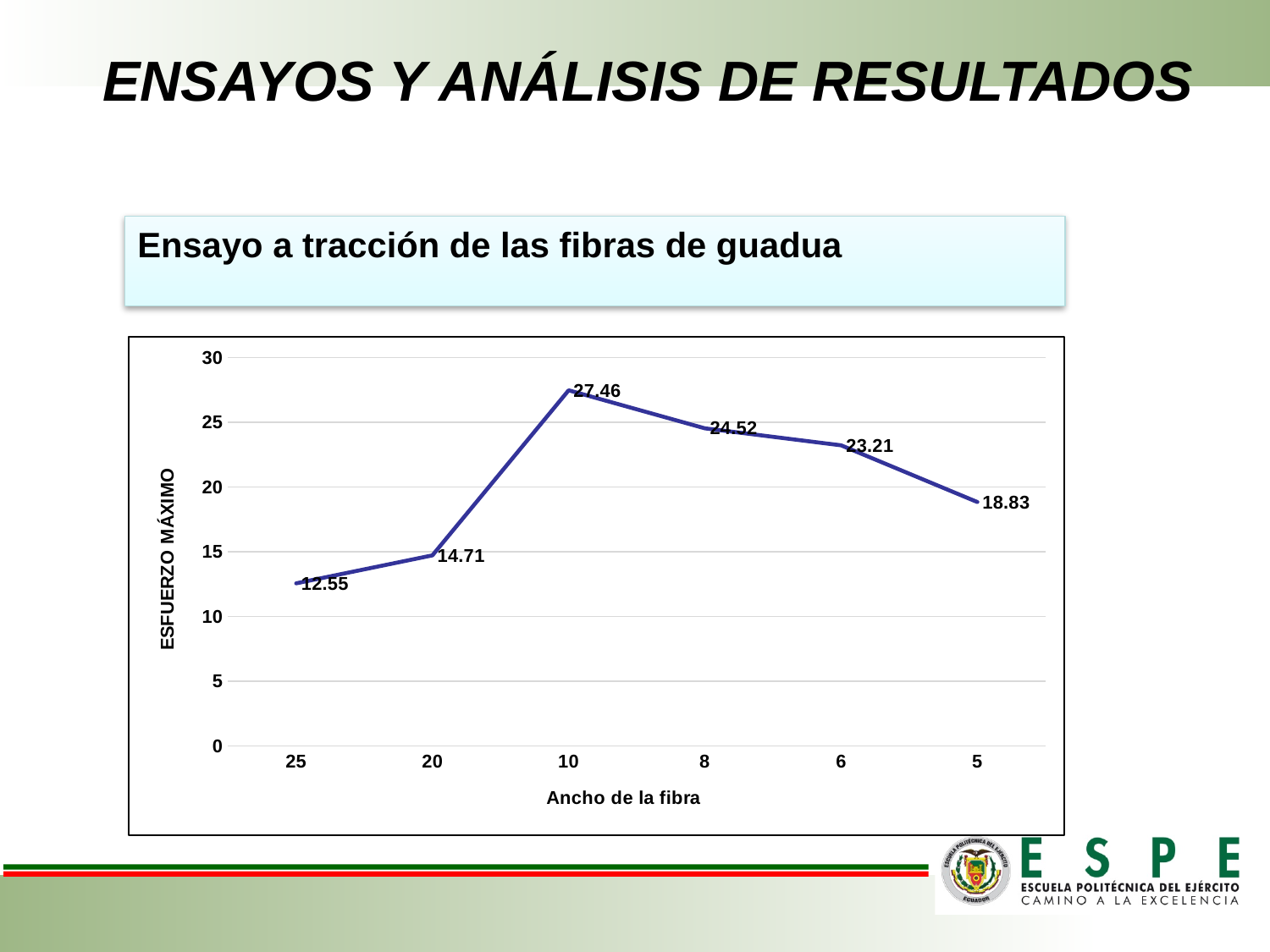
How many Ancho de la fibra categories are plotted on the x axis? 6 What kind of chart is shown on the slide? Line chart What is the ESFUERZO MÁXIMO value for Ancho de la fibra 5? 18.83 Which Ancho de la fibra category has the highest ESFUERZO MÁXIMO? 10 What is the ESFUERZO MÁXIMO value for Ancho de la fibra 25? 12.55 What is the ESFUERZO MÁXIMO value for Ancho de la fibra 10? 27.46 Which Ancho de la fibra category has the lowest ESFUERZO MÁXIMO? 25 Does the ESFUERZO MÁXIMO value rise or fall from Ancho de la fibra 10 to Ancho de la fibra 5 along the x axis? Fall What is the label of the x axis of the chart? Ancho de la fibra What is the difference between the ESFUERZO MÁXIMO values for Ancho de la fibra 8 and Ancho de la fibra 6? 1.31 Which has a larger ESFUERZO MÁXIMO value: Ancho de la fibra 20 or Ancho de la fibra 5? 5 What is the difference between the ESFUERZO MÁXIMO values for Ancho de la fibra 10 and Ancho de la fibra 25? 14.91